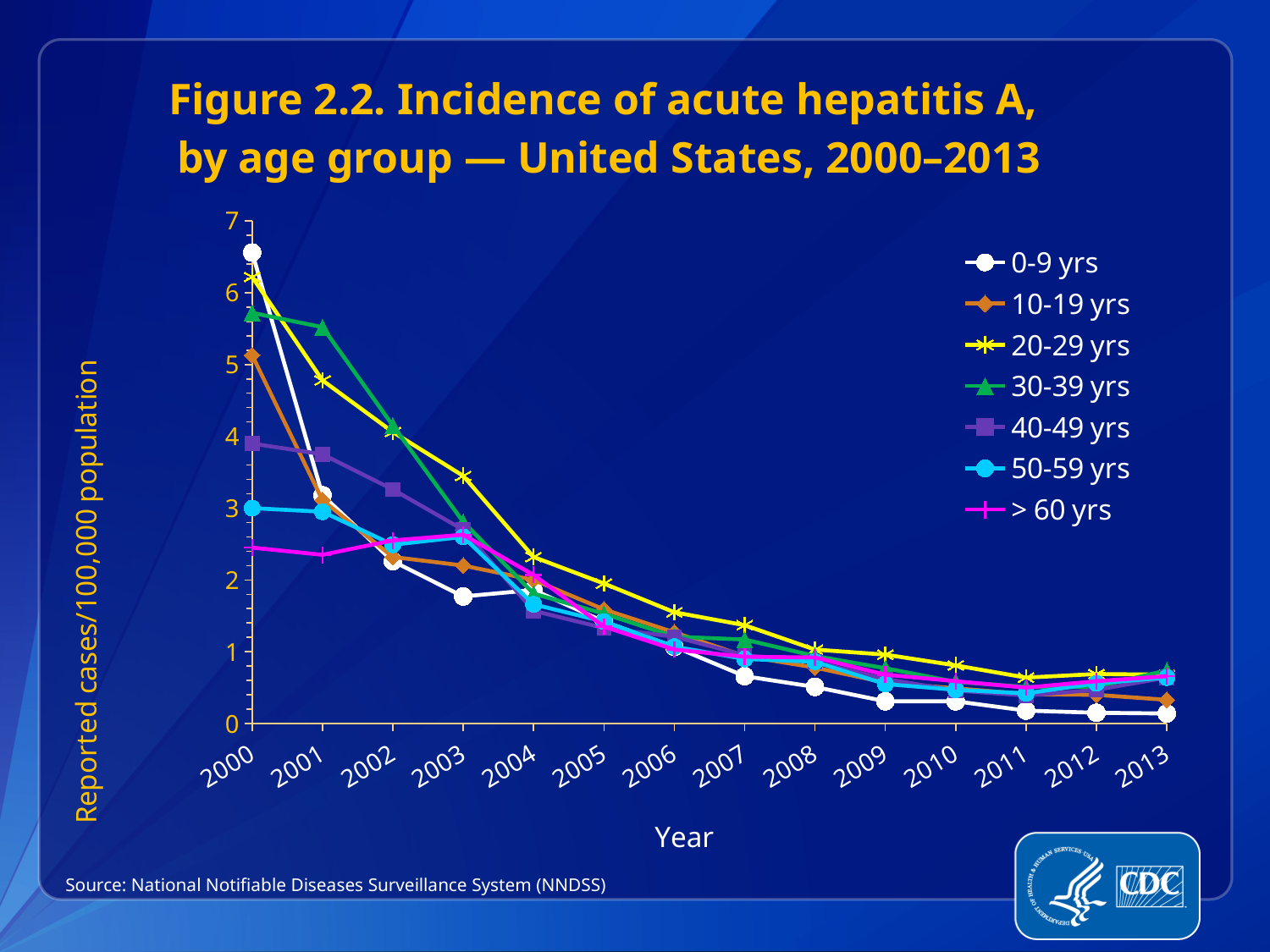
Is the value for 0-9 yrs in 2013 greater or less than 1? less Which age group has the highest incidence in 2000? 0-9 yrs What kind of chart is shown on the slide? Line chart In 2001, which is larger: the value for 20-29 yrs or the value for 40-49 yrs? 20-29 yrs Is the value for 0-9 yrs in 2000 greater or less than 6? greater Which age group has the highest incidence in 2001? 30-39 yrs Is the value for 20-29 yrs in 2003 greater or less than 3? greater Which age group has the lowest incidence in 2013? 0-9 yrs Which age group has the lowest incidence in 2000? > 60 yrs How many age-group series does the legend list? 7 Does the incidence for 0-9 yrs rise or fall from 2000 to 2013? Fall How many years are plotted along the x axis? 14